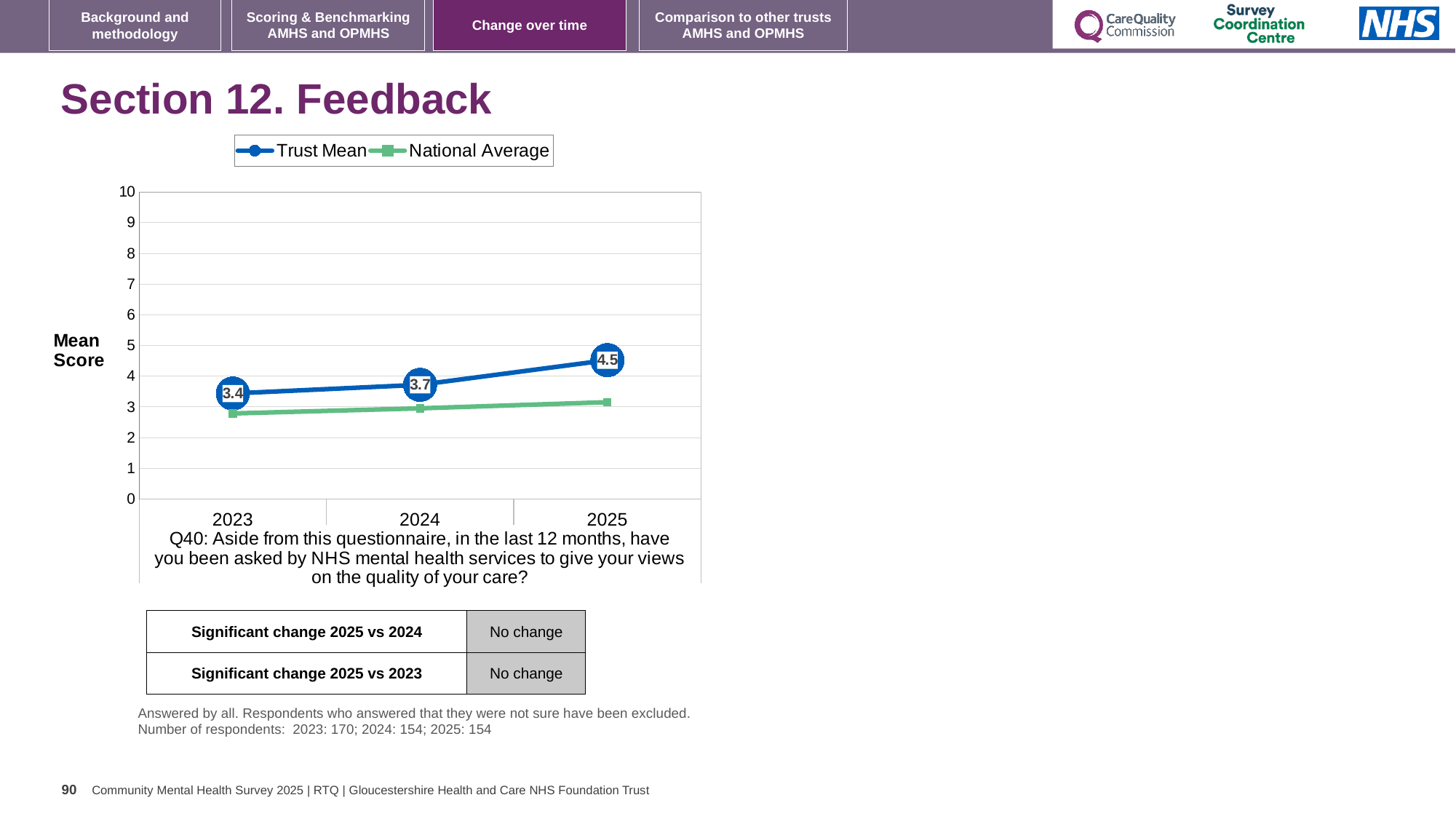
In which year is the Trust Mean highest? 2025 How many series does the legend list? 2 What is the Trust Mean score for 2024? 3.7 What is the difference between the Trust Mean in 2025 and in 2023? 1.1 What is the Trust Mean score for 2023? 3.4 How many years are shown on the x axis? 3 Which is larger in 2025, the Trust Mean or the National Average? Trust Mean In which year is the Trust Mean lowest? 2023 Is the Trust Mean value for 2025 greater or less than 4? greater What is the Trust Mean score for 2025? 4.5 What kind of chart is shown on the slide? line chart Is the National Average value for 2023 greater or less than 3? less